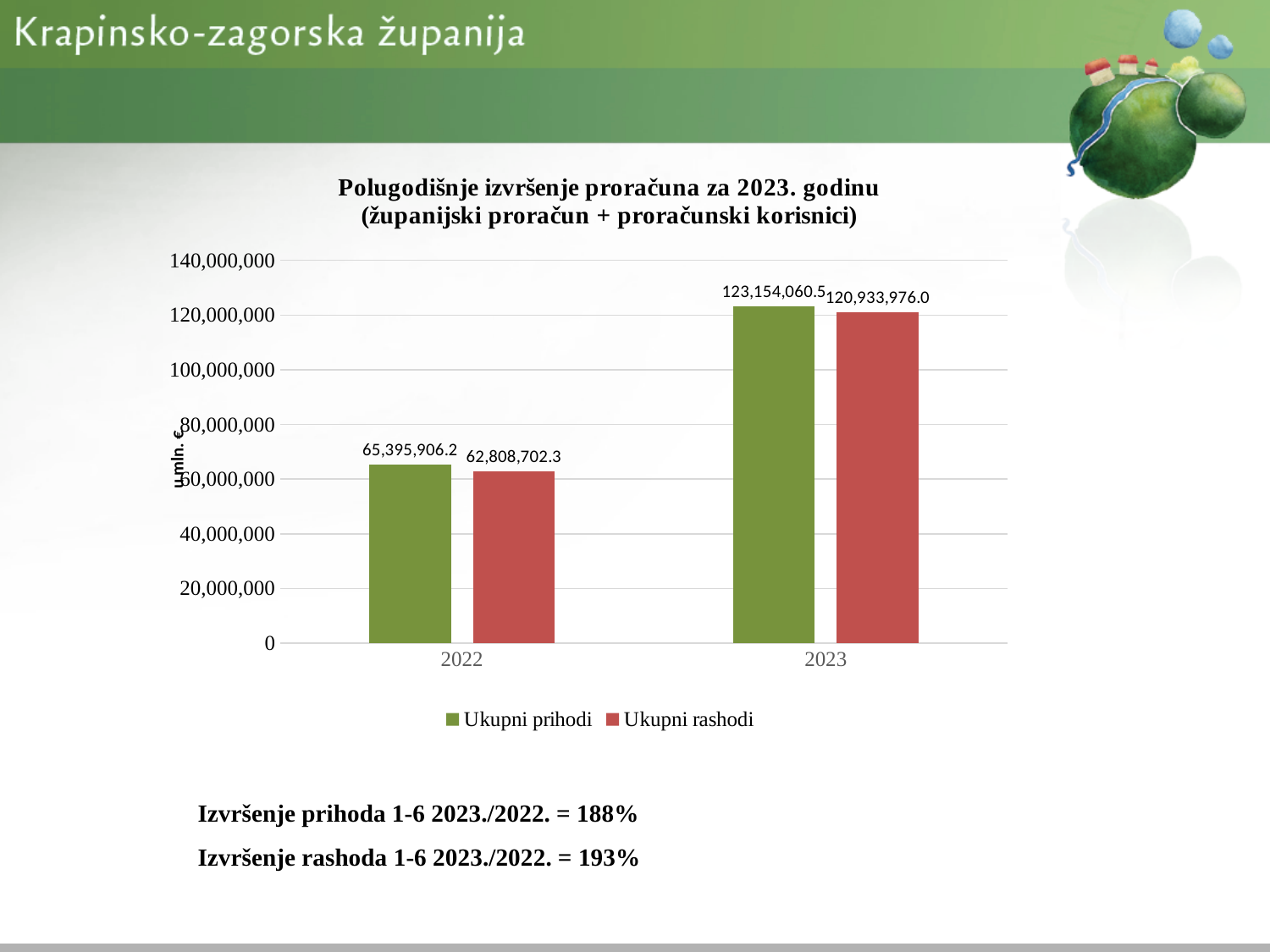
Which bar has the lowest value in the chart? Ukupni rashodi for 2022 What is the difference between Ukupni prihodi in 2023 and Ukupni prihodi in 2022? 57,758,154.3 Do the values for Ukupni rashodi rise or fall from 2022 to 2023? rise What is the value of Ukupni prihodi for 2023? 123,154,060.5 What is the value of Ukupni rashodi for 2022? 62,808,702.3 What type of chart is shown on the slide? bar chart Which year has the higher value for Ukupni prihodi? 2023 What is the value of Ukupni rashodi for 2023? 120,933,976.0 What is the value of Ukupni prihodi for 2022? 65,395,906.2 How many series does the legend list? 2 What is the difference between Ukupni prihodi and Ukupni rashodi in 2022? 2,587,203.9 In 2023, which is larger: Ukupni prihodi or Ukupni rashodi? Ukupni prihodi